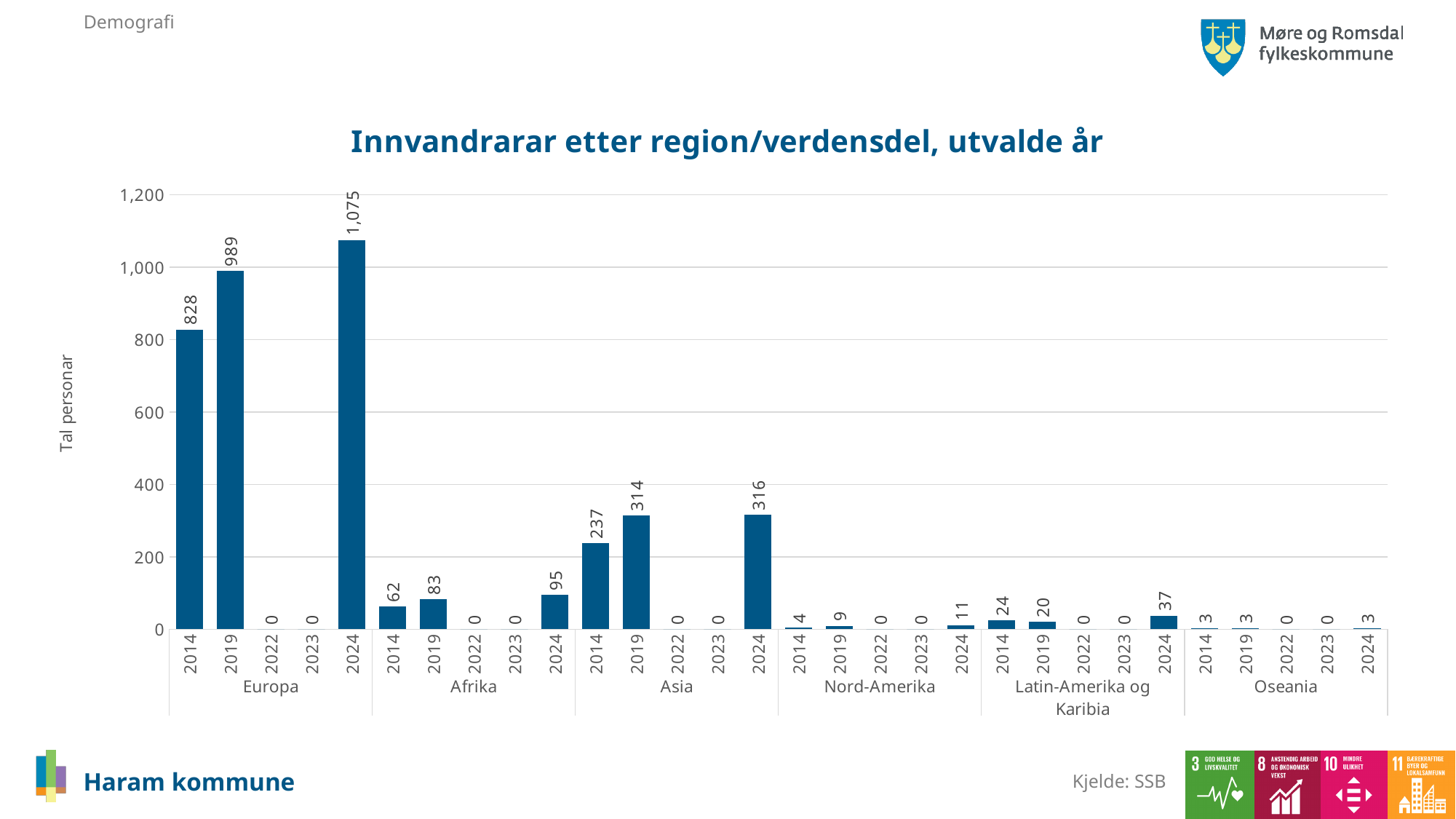
Which is larger: Asia in 2024 or Asia in 2019? Asia in 2024 What kind of chart is this? Bar chart What is the title of the chart? Innvandrarar etter region/verdensdel, utvalde år What is the difference between the Europa values for 2024 and 2014? 247 What is the label on the vertical axis? Tal personar What is the value for Latin-Amerika og Karibia in 2024? 37 How many regions are shown on the x axis? 6 Which region has the highest bar in 2024? Europa What is the value for Afrika in 2014? 62 What is the value for Asia in 2019? 314 Which region has the lowest value in 2019? Oseania What is the value for Europa in 2024? 1,075